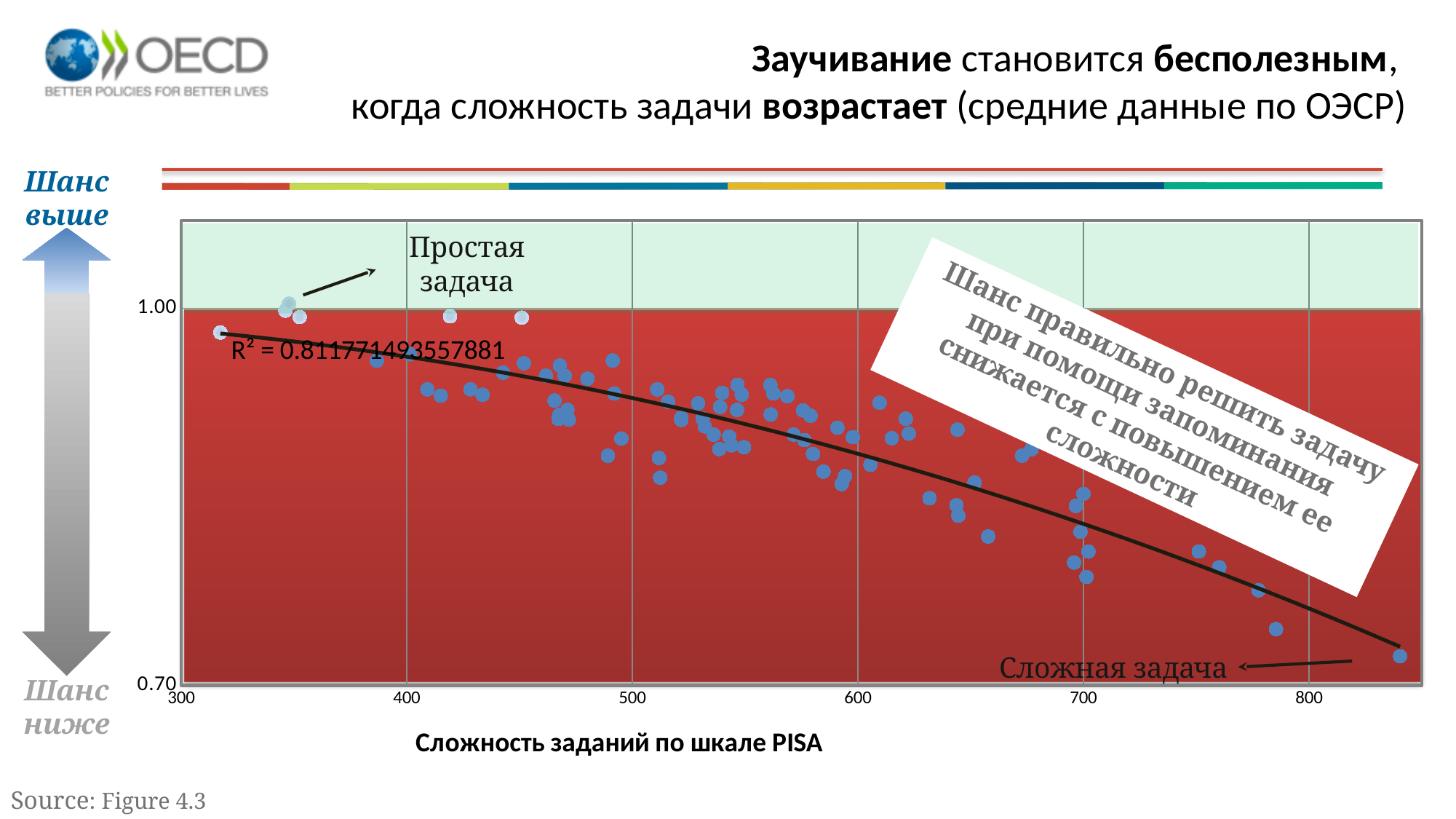
Is the value for the rightmost point (near 840 on the x axis) greater or less than 1.00? less What is the label of the x axis of the chart? Сложность заданий по шкале PISA What R² value is printed on the chart? R² = 0.811771493557881 What is the leftmost tick value on the x axis of the chart? 300 What is the lowest value shown on the y axis of the chart? 0.70 Is the value for the leftmost point (near 320 on the x axis) greater or less than 0.70? greater What is the highest value shown on the y axis of the chart? 1.00 What kind of chart is shown on the slide? Scatter chart Which end of the x axis has the higher plotted values: the low-difficulty end (near 300) or the high-difficulty end (near 800)? The low-difficulty end (near 300) Which annotation label is placed near the points at the top-left of the chart? Простая задача Do the plotted values rise or fall as the task difficulty on the PISA scale increases along the x axis? Fall